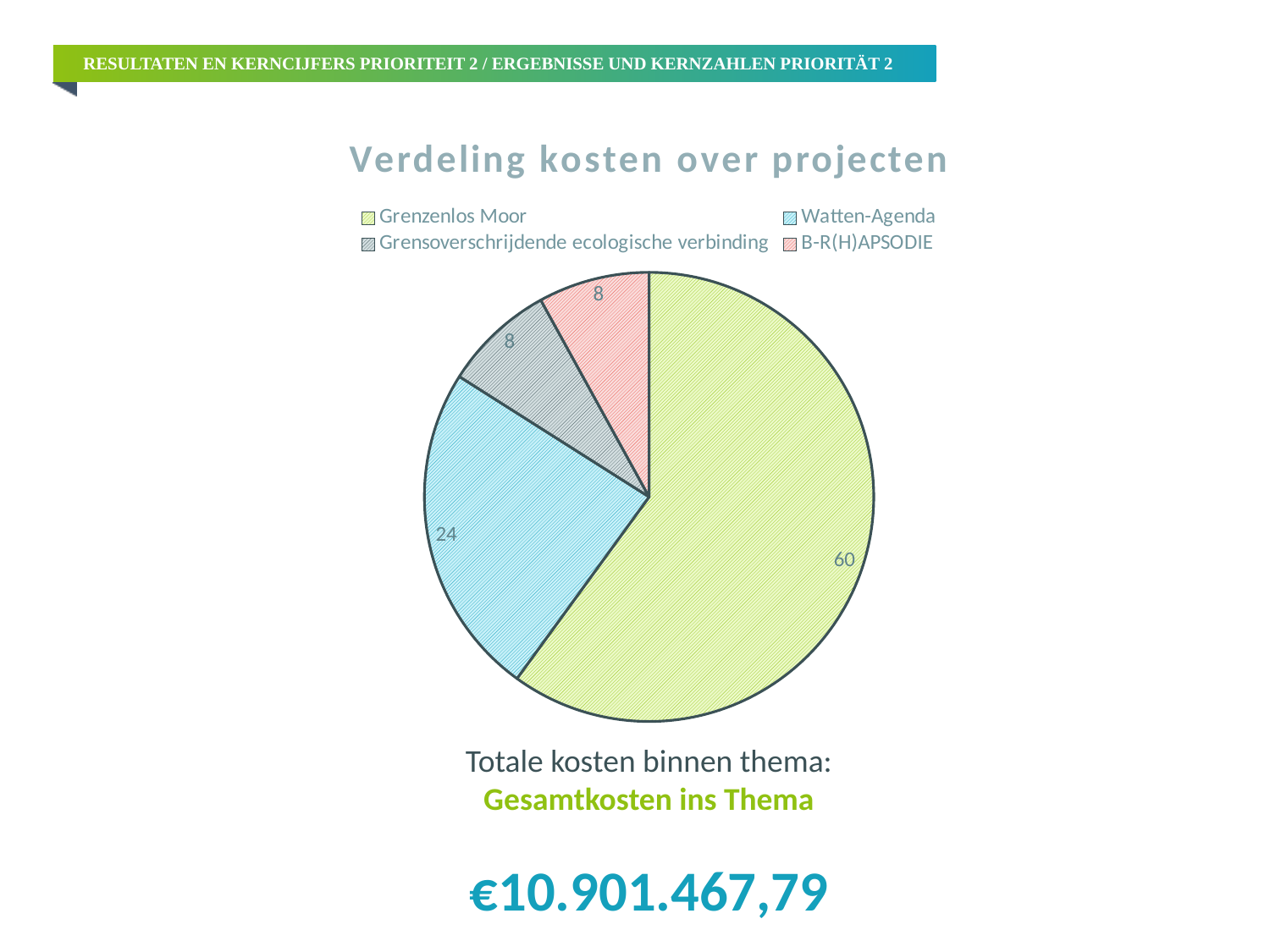
How many entries does the legend list? 4 What share of the pie does Grenzenlos Moor represent? 60% What is the title of the chart? Verdeling kosten over projecten What is the value shown for Grensoverschrijdende ecologische verbinding? 8 What is the value shown for B-R(H)APSODIE? 8 How many slices does the pie chart have? 4 What is the value shown for Watten-Agenda? 24 Which project has the largest slice of the pie? Grenzenlos Moor Which is larger, the value for Watten-Agenda or the value for B-R(H)APSODIE? Watten-Agenda What type of chart is shown on the slide? pie chart What is the difference between the values for Grenzenlos Moor and Watten-Agenda? 36 What is the value shown for Grenzenlos Moor? 60